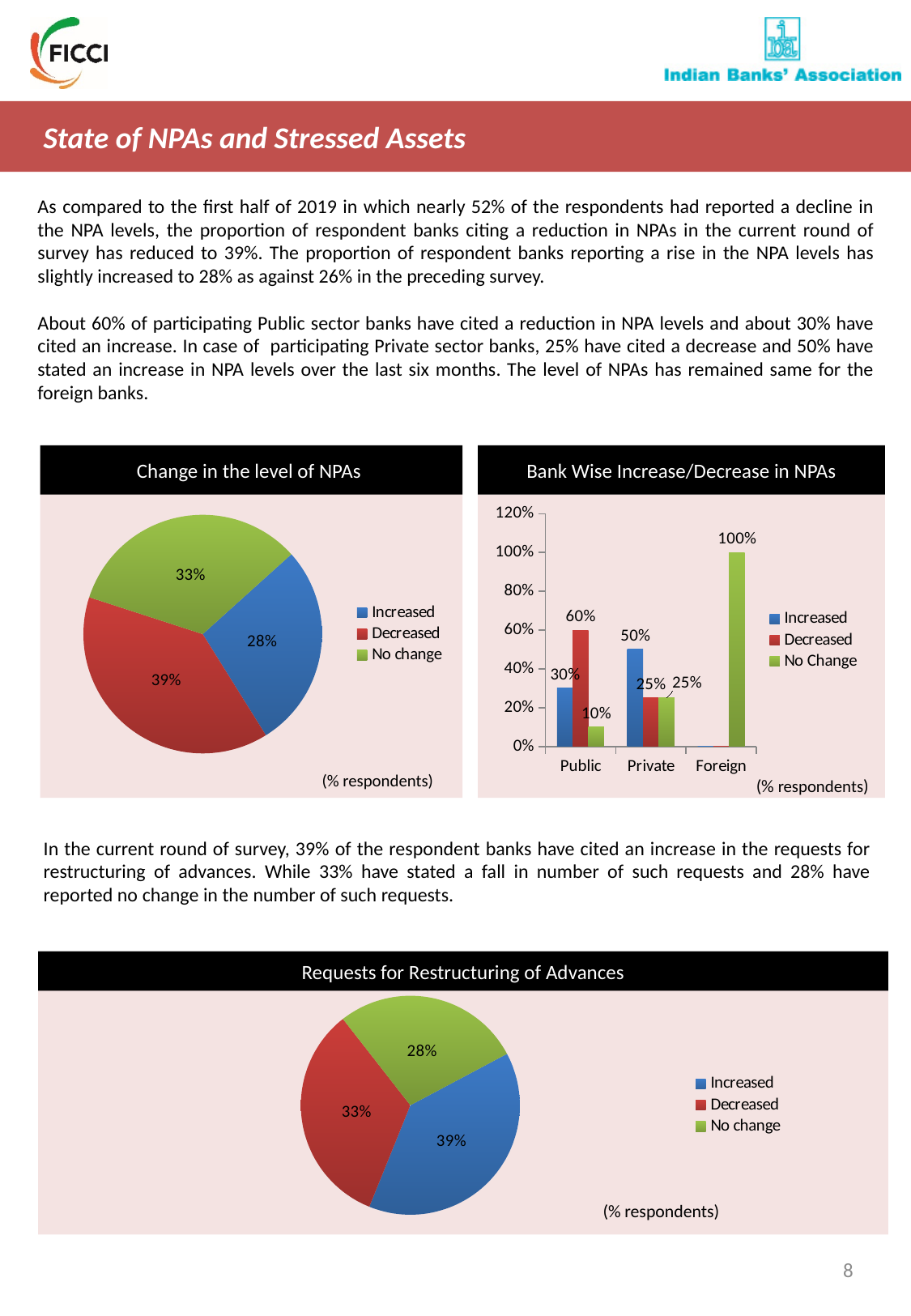
In the 'Requests for Restructuring of Advances' chart, what share of respondents reported an increase? 39% In the 'Bank Wise Increase/Decrease in NPAs' chart, which is larger for Public banks: Increased or No Change? Increased In the 'Requests for Restructuring of Advances' chart, what is the difference between the Decreased and No change shares? 5% In the 'Bank Wise Increase/Decrease in NPAs' chart, what is the value for Decreased for Public banks? 60% In the 'Bank Wise Increase/Decrease in NPAs' chart, what is the value for No Change for Foreign banks? 100% What kind of chart is 'Bank Wise Increase/Decrease in NPAs'? Bar chart How many bank categories are shown on the x axis of the 'Bank Wise Increase/Decrease in NPAs' chart? 3 How many series does the legend of the 'Bank Wise Increase/Decrease in NPAs' chart list? 3 In the 'Change in the level of NPAs' chart, which category has the smallest share? Increased In the 'Change in the level of NPAs' chart, what share of respondents reported that NPAs decreased? 39% What kind of chart is 'Change in the level of NPAs'? Pie chart In the 'Bank Wise Increase/Decrease in NPAs' chart, what is the difference between Increased and Decreased for Private banks? 25%